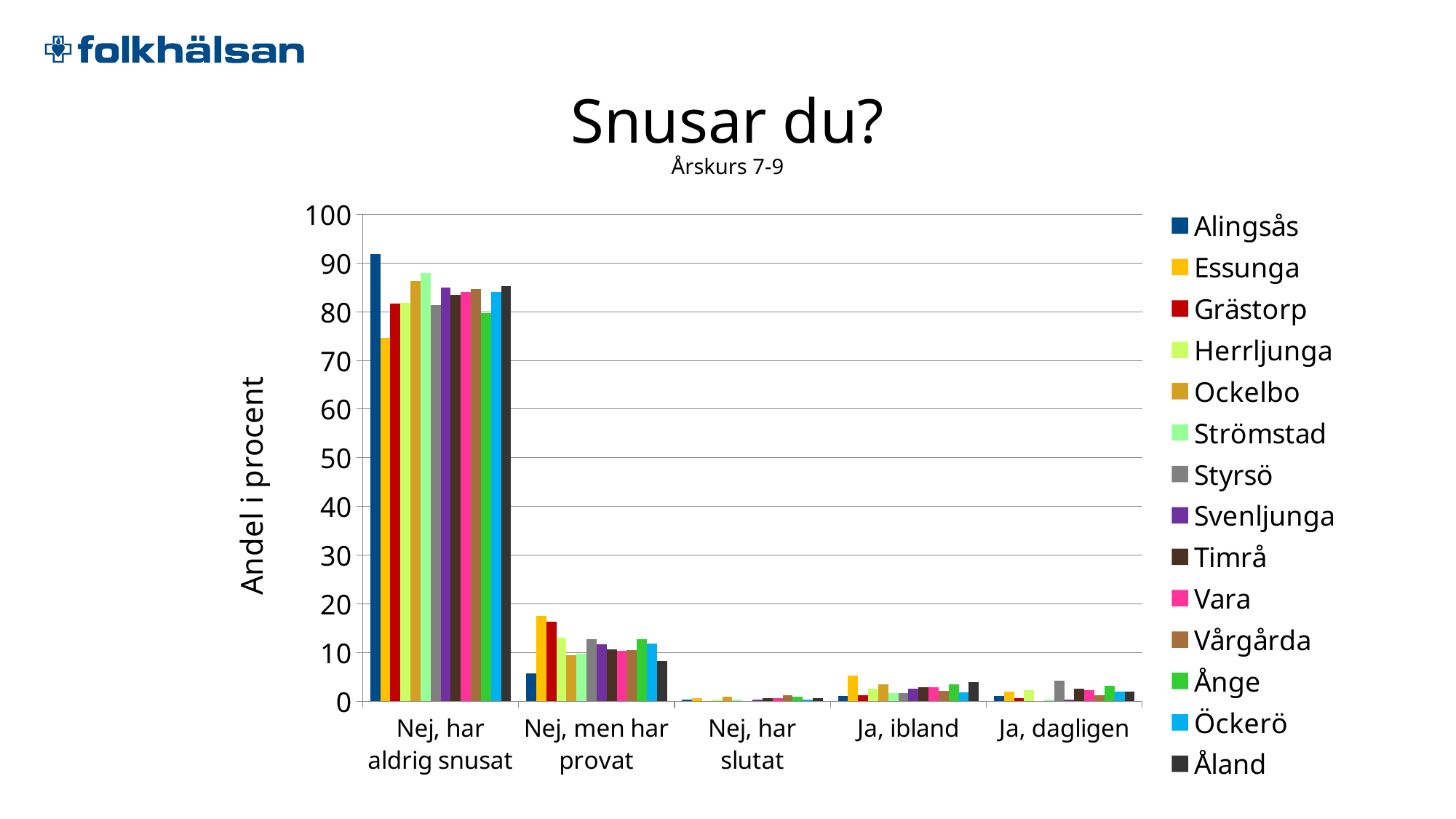
How many series does the legend list? 14 In the 'Nej, har aldrig snusat' category, which is larger: Alingsås or Essunga? Alingsås Which series has the highest value in the 'Nej, har aldrig snusat' category? Alingsås What is the label of the y axis? Andel i procent Which series has the lowest value in the 'Nej, har aldrig snusat' category? Essunga In the 'Nej, men har provat' category, which is larger: Essunga or Alingsås? Essunga How many categories are shown on the x axis? 5 Which series has the lowest value in the 'Nej, men har provat' category? Alingsås Is the value for Essunga in 'Nej, men har provat' greater or less than 10? greater Is the value for Alingsås in 'Nej, har aldrig snusat' greater or less than 90? greater Is the value for Essunga in 'Nej, har aldrig snusat' greater or less than 80? less What kind of chart is shown on the slide? bar chart